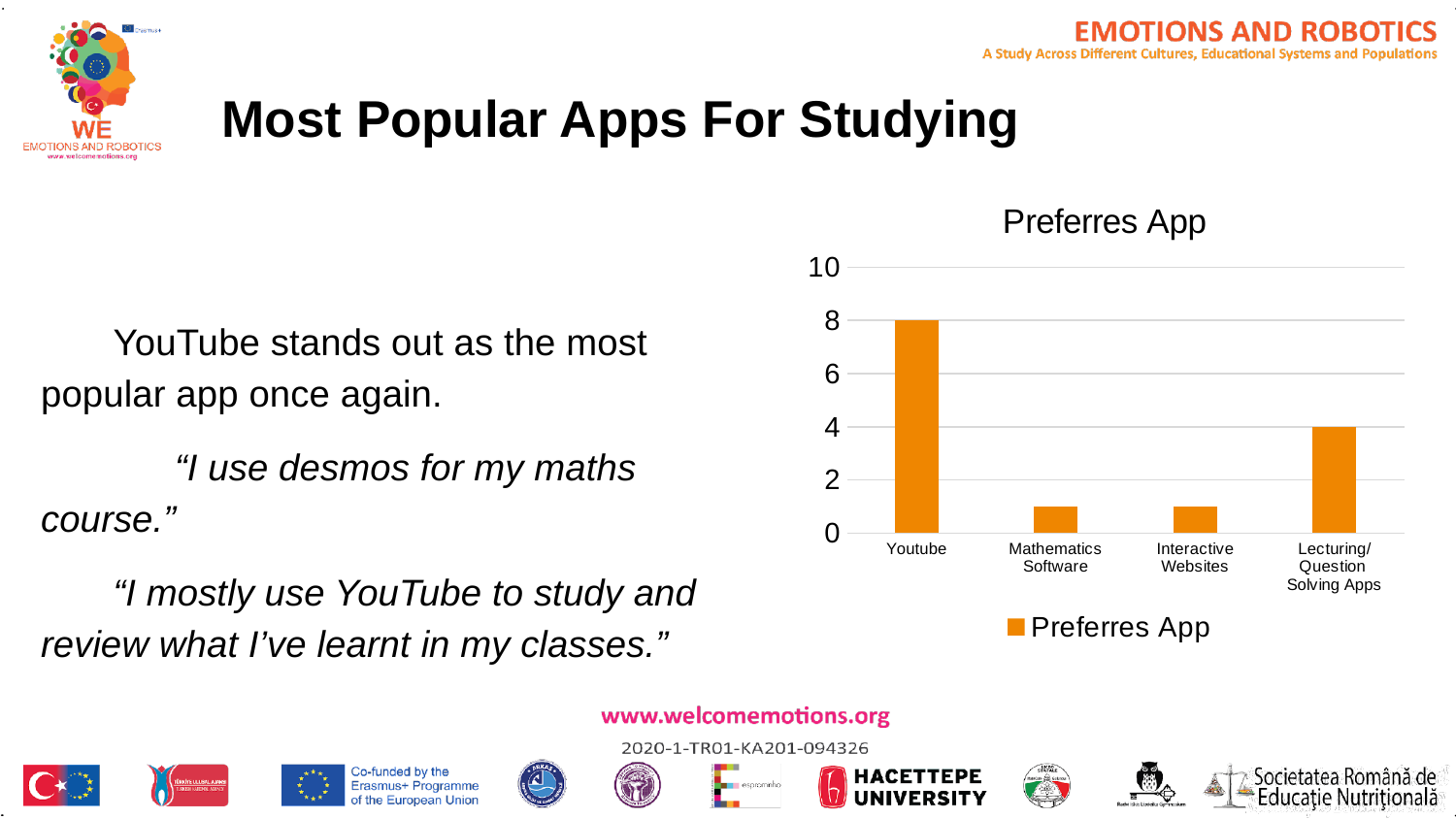
How many series does the chart legend list? 1 What is the title of the chart? Preferres App How many categories are shown on the x axis of the chart? 4 Which category has the highest value in the chart? Youtube What is the value for Lecturing/Question Solving Apps in the chart? 4 Is the value for Mathematics Software greater or less than 2? less What is the value for Youtube in the chart? 8 Which is larger, the value for Youtube or the value for Lecturing/Question Solving Apps? Youtube What type of chart is shown on the slide? bar chart What colour are the bars in the chart? orange What is the difference between the values for Youtube and Lecturing/Question Solving Apps? 4 Is the value for Interactive Websites greater or less than 2? less